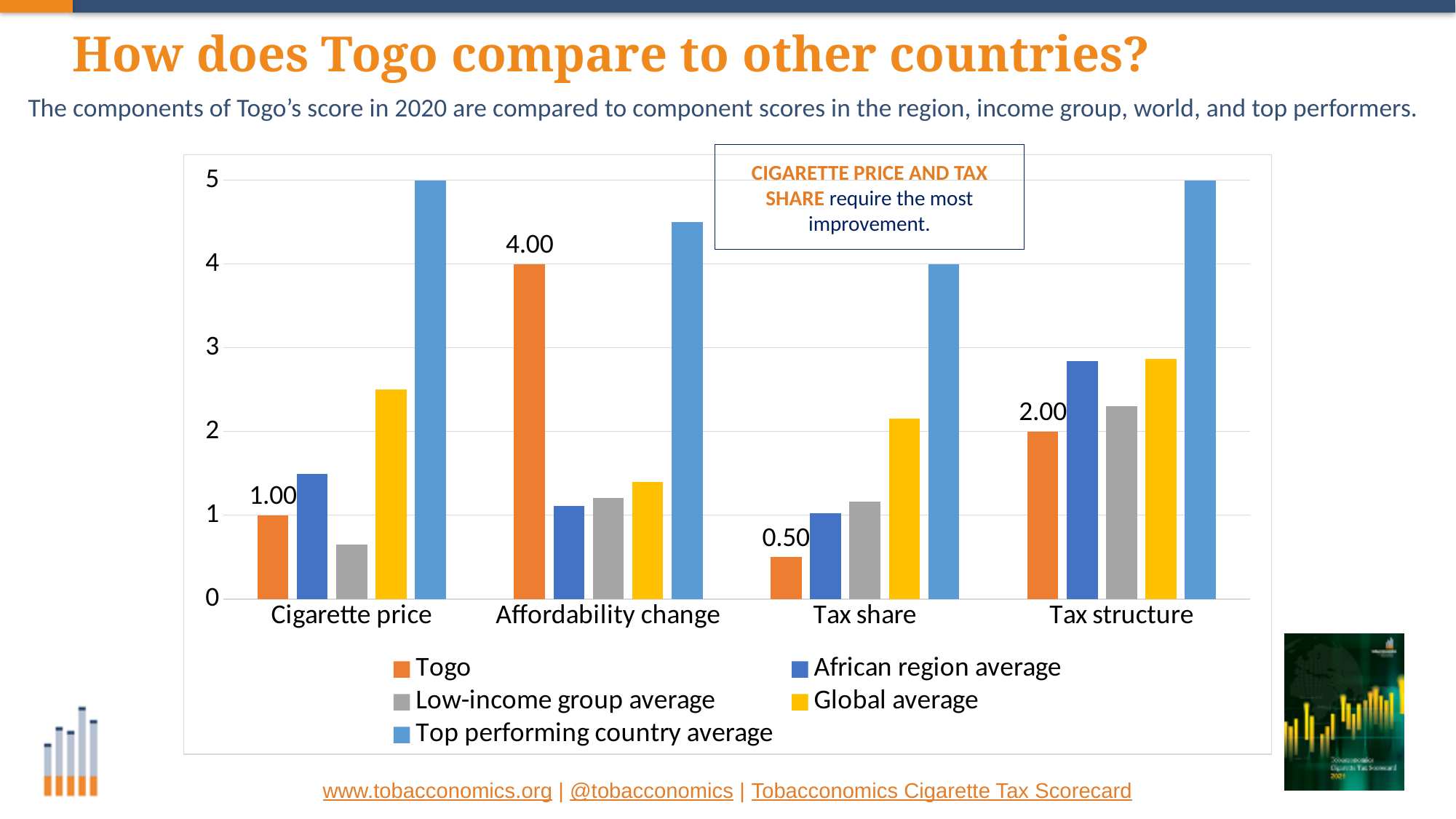
In which component does Togo have its lowest score? Tax share What is Togo's score for Tax share? 0.50 What type of chart is shown on the slide? Bar chart How many series does the legend list? 5 What is Togo's score for Affordability change? 4.00 In which component does Togo have its highest score? Affordability change Is the Top performing country average for Affordability change greater or less than 4? greater What is the difference between Togo's Affordability change score and its Tax share score? 3.50 What is Togo's score for Tax structure? 2.00 Is the Global average for Cigarette price greater or less than 2? greater For Tax structure, which is larger: the African region average or the Low-income group average? African region average What is Togo's score for Cigarette price? 1.00